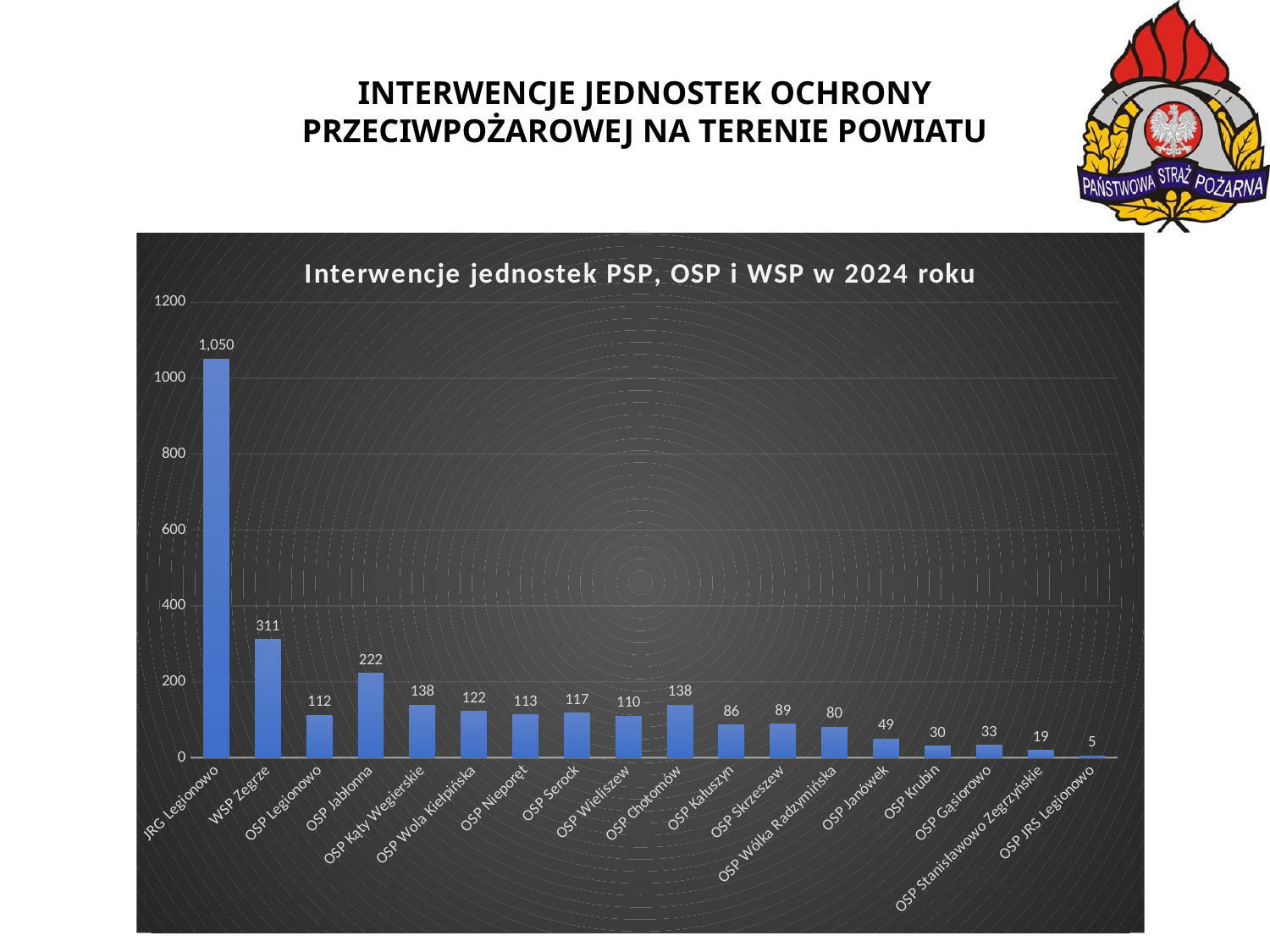
What is the title of the chart? Interwencje jednostek PSP, OSP i WSP w 2024 roku What is the value for OSP Wólka Radzymińska? 80 What is the difference between the values for WSP Zegrze and OSP Jabłonna? 89 Which is larger, the value for OSP Skrzeszew or the value for OSP Kałuszyn? OSP Skrzeszew What kind of chart is shown on the slide? bar chart Is the value for WSP Zegrze greater or less than 400? less Which category has the highest value? JRG Legionowo What is the value for JRG Legionowo? 1,050 Which category has the lowest value? OSP JRS Legionowo What is the value for OSP Jabłonna? 222 What is the value for OSP Stanisławowo Zegrzyńskie? 19 How many categories are shown on the x axis? 18